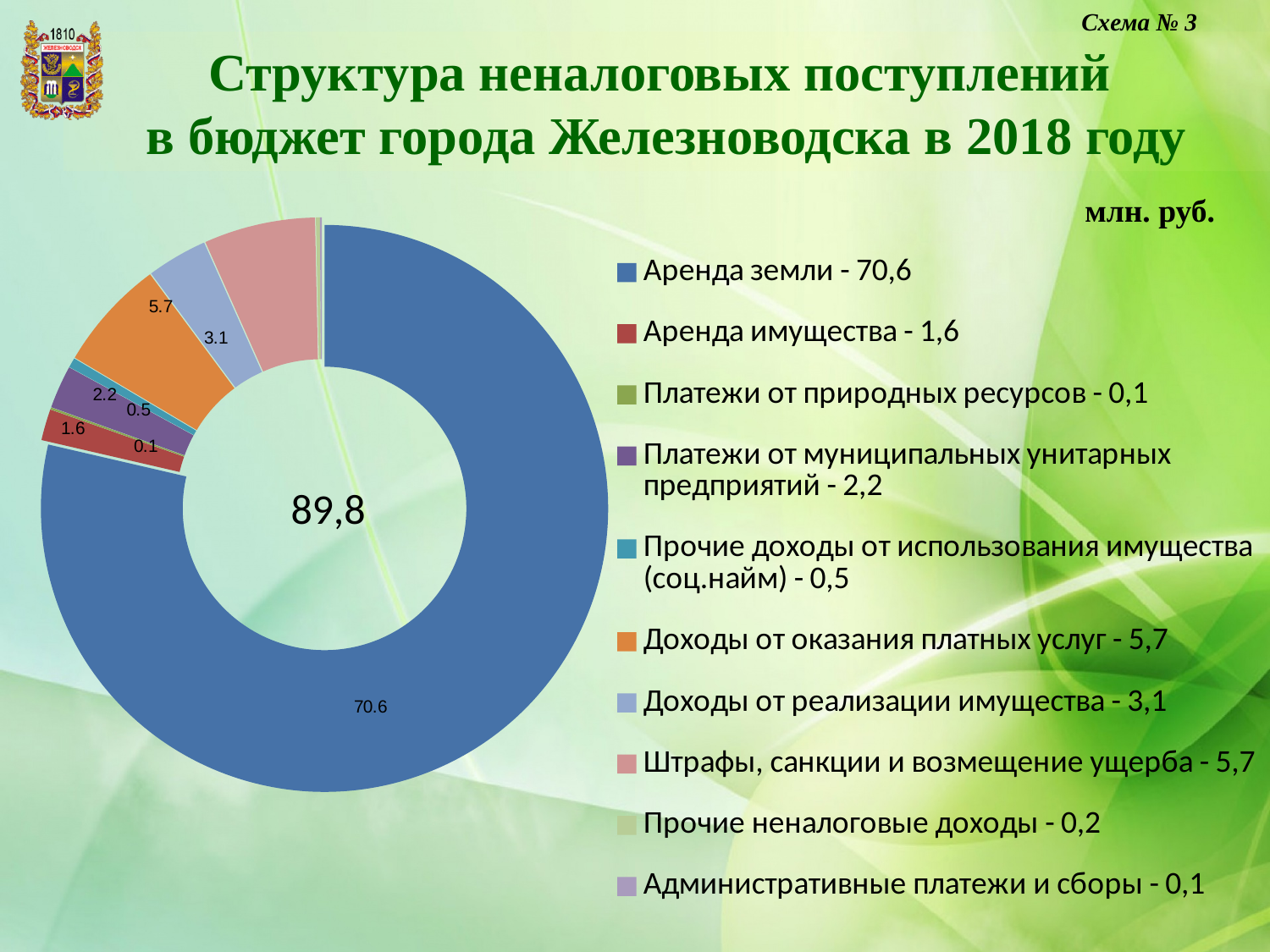
What is the value for Аренда земли? 70,6 What is the difference between Аренда земли and Штрафы, санкции и возмещение ущерба? 64,9 Which is larger: Доходы от реализации имущества or Аренда имущества? Доходы от реализации имущества What unit of measurement is indicated for the chart values? млн. руб. What is the value for Платежи от муниципальных унитарных предприятий? 2,2 Which category has the largest value? Аренда земли What is the value for Доходы от оказания платных услуг? 5,7 What is the value for Доходы от реализации имущества? 3,1 What total value is shown in the centre of the chart? 89,8 What is the value for Прочие неналоговые доходы? 0,2 How many categories does the legend list? 10 What type of chart is shown on the slide? Doughnut (pie) chart